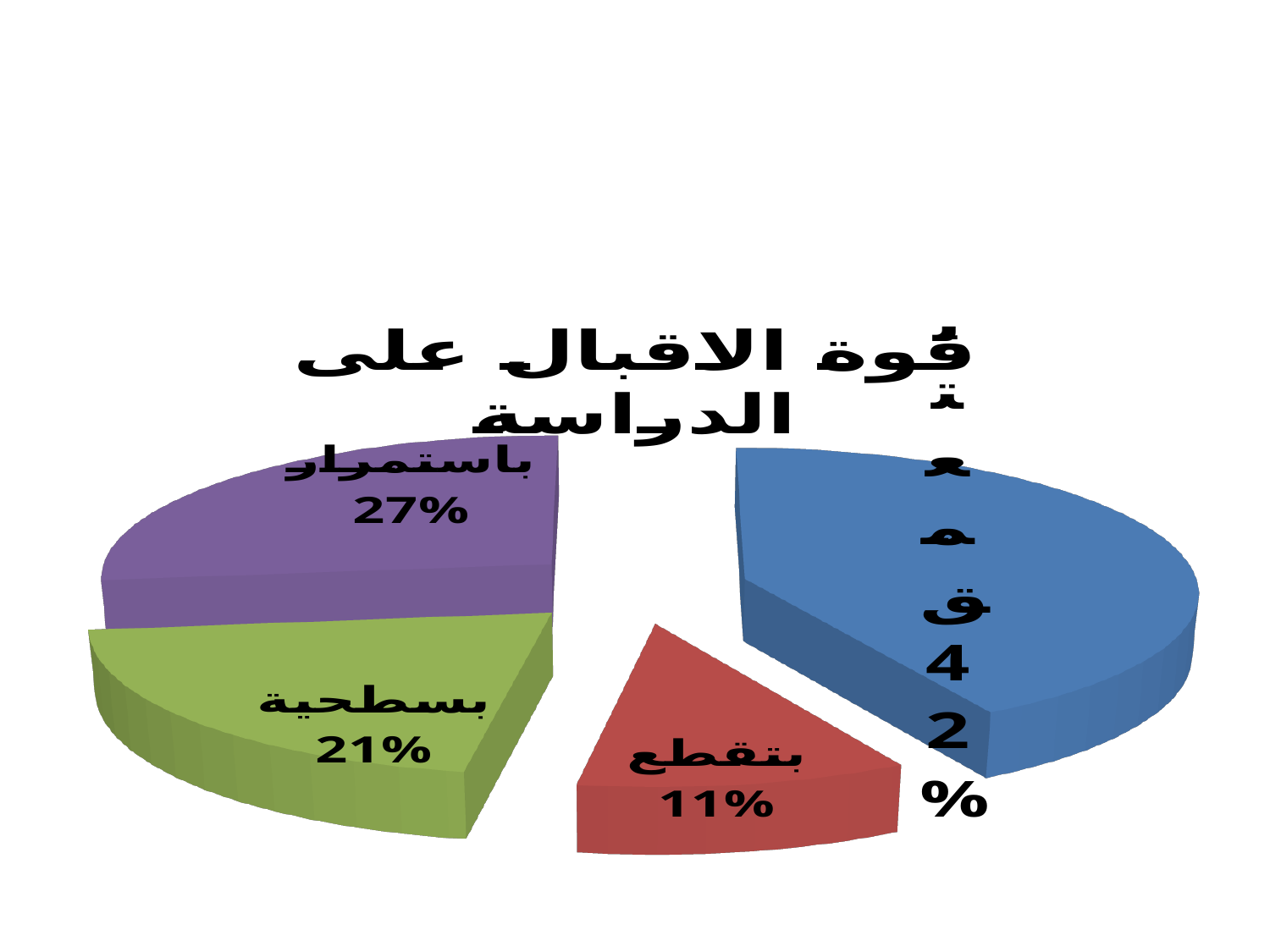
How many slices does the pie chart have? 4 What percentage is shown for the slice labelled باستمرار? 27% What is the title of the chart? قُوة الاقبال على الدراسة What is the difference in percentage points between the باستمرار slice and the بتقطع slice? 16 What percentage is shown for the slice labelled بسطحية? 21% What kind of chart is shown on the slide? pie chart Which slice is larger, باستمرار or بسطحية? باستمرار What colour is the slice labelled بسطحية? green What percentage is shown for the slice labelled بتقطع? 11% What percentage is shown for the slice labelled بتعمق? 42% Which slice has the largest share of the pie? بتعمق Which slice has the smallest share of the pie? بتقطع